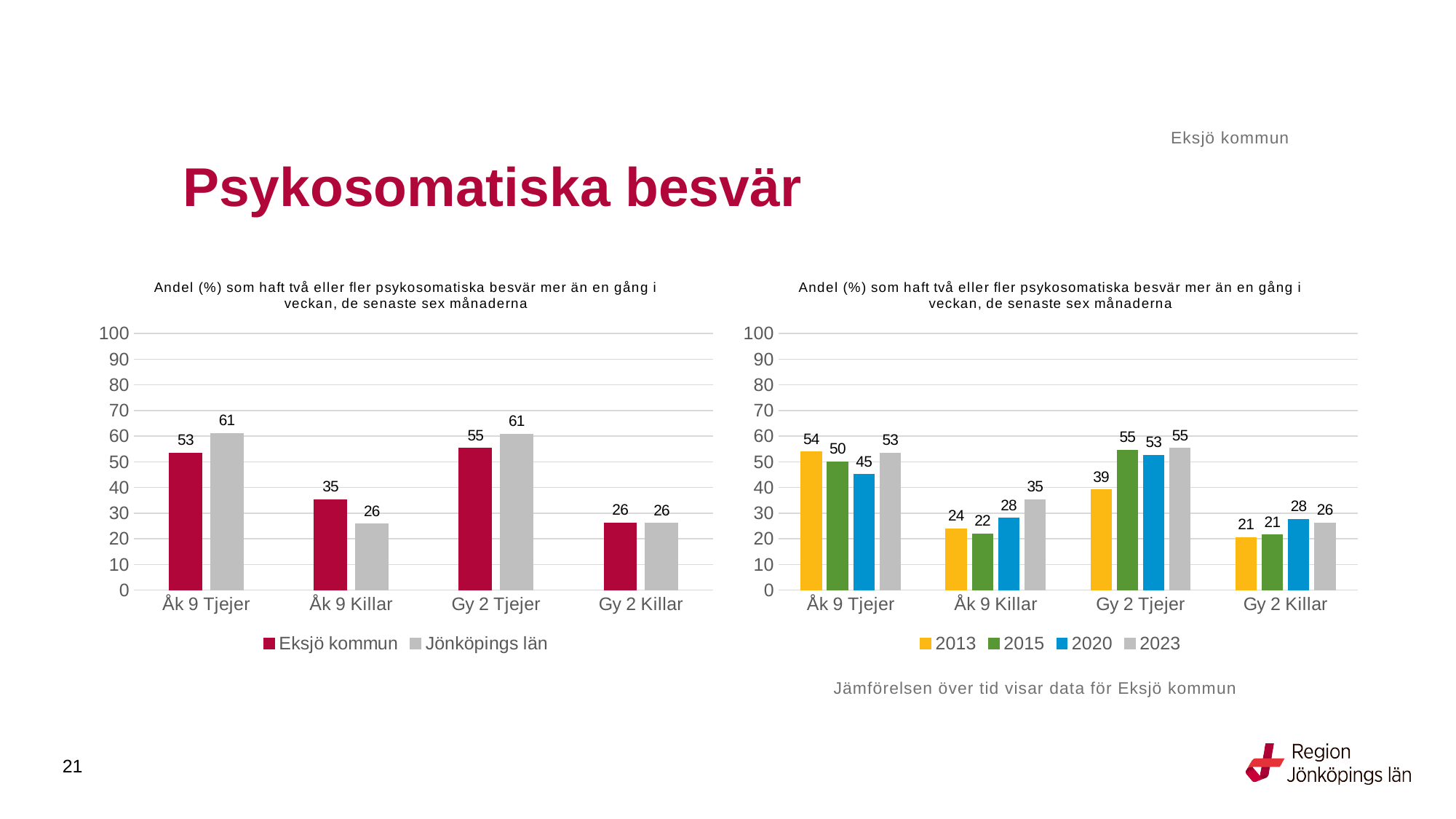
In the right chart, how many series does the legend list? 4 In the right chart, is the value for 2015 for Gy 2 Killar larger or smaller than the value for 2020 for Gy 2 Killar? smaller In the left chart, what is the value for Eksjö kommun for Åk 9 Tjejer? 53 In the left chart, what is the value for Jönköpings län for Gy 2 Tjejer? 61 In the left chart, which category has the lowest value for Eksjö kommun? Gy 2 Killar In the left chart, how many series does the legend list? 2 In the left chart, what is the difference between Jönköpings län and Eksjö kommun for Åk 9 Tjejer? 8 What kind of chart is the left chart? bar chart In the right chart, how many categories are shown on the x axis? 4 In the right chart, what is the value for 2013 for Gy 2 Tjejer? 39 In the right chart, which year has the highest value for Åk 9 Killar? 2023 In the right chart, what is the value for 2020 for Åk 9 Tjejer? 45